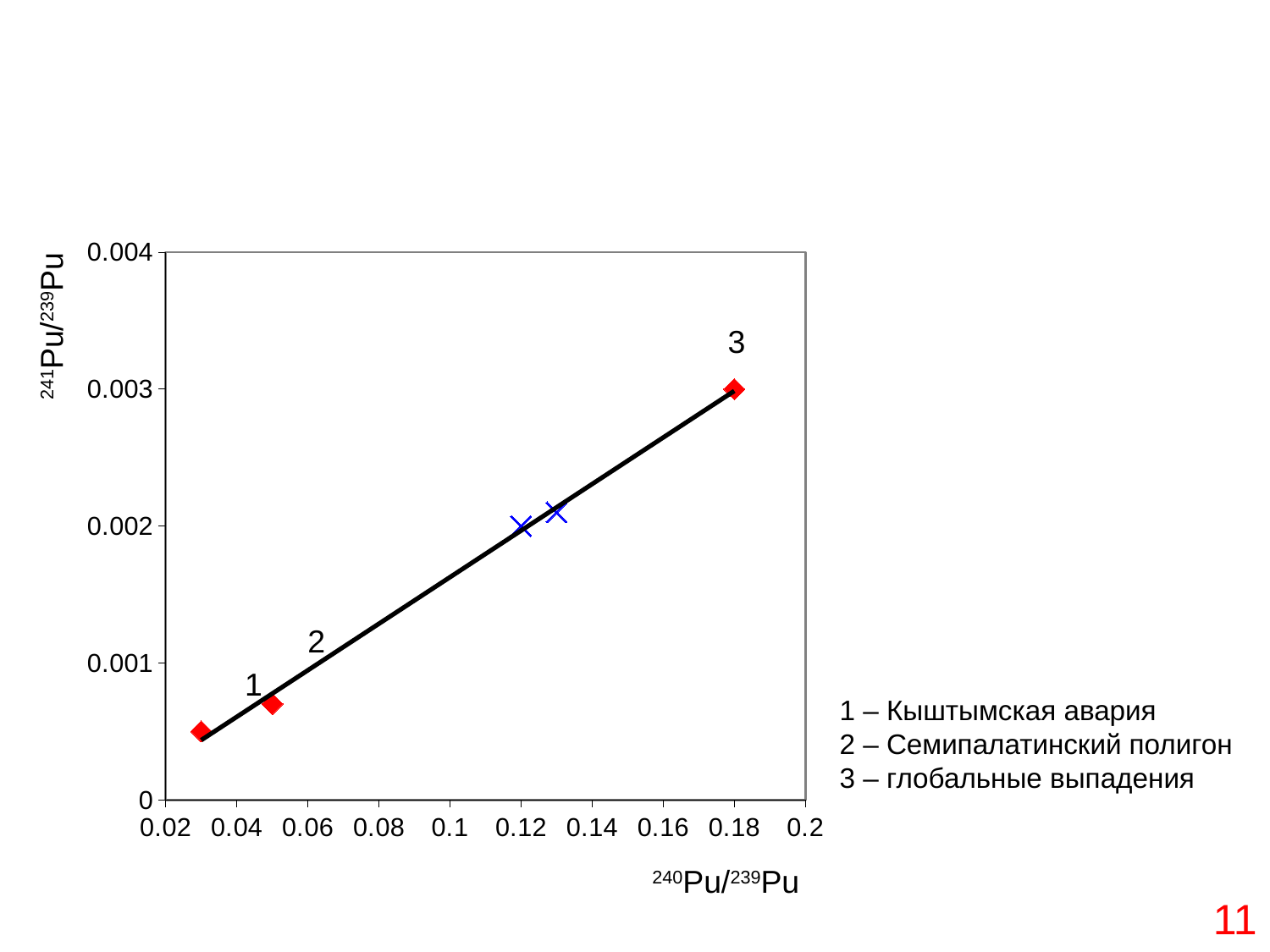
Which has a larger 241Pu/239Pu value, point 1 or point 3? point 3 Is the 240Pu/239Pu value of point 1 (Кыштымская авария) greater or less than 0.1? less How many red diamond points are plotted on the chart? 3 How many blue cross markers are plotted on the chart? 2 What kind of chart is shown on the slide? scatter chart What is the label of the horizontal axis? 240Pu/239Pu Is the 241Pu/239Pu value of point 1 (Кыштымская авария) greater or less than 0.001? less Which numbered point has the highest 241Pu/239Pu value? 3 What is the 241Pu/239Pu value of point 3 (глобальные выпадения)? 0.003 Do the 241Pu/239Pu values rise or fall as 240Pu/239Pu increases along the x axis? rise What is the 240Pu/239Pu value of point 3 (глобальные выпадения)? 0.18 What is the label of the vertical axis? 241Pu/239Pu